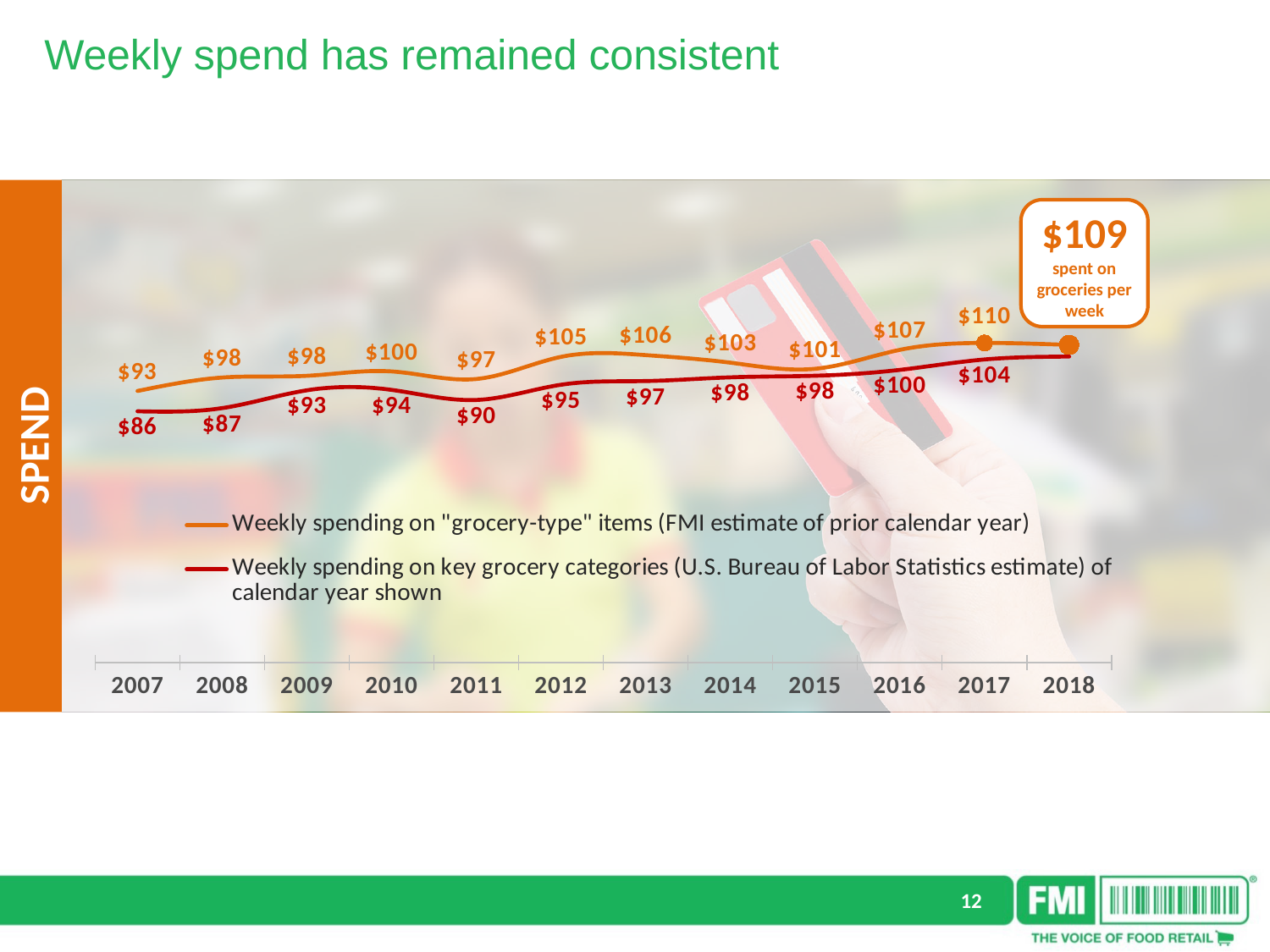
In 2011, which series has the higher value: the orange FMI estimate or the red Bureau of Labor Statistics estimate? The orange FMI estimate What is the value of the FMI estimate series (orange line) for 2017? $110 According to the callout, how much was spent on groceries per week in 2018 (orange line)? $109 What is the value of the U.S. Bureau of Labor Statistics series (red line) for 2007? $86 What is the difference between the orange line's 2013 value and its 2007 value? $13 Does the red Bureau of Labor Statistics line rise or fall from 2007 to 2010? Rise In which year does the orange FMI estimate line reach its highest value? 2017 In which year is the red Bureau of Labor Statistics line at its lowest value? 2007 What type of chart is shown on the slide? Line chart How many series does the legend list? 2 How many years are shown on the x axis of the chart? 12 In 2016, what is the difference between the orange line value and the red line value? $7